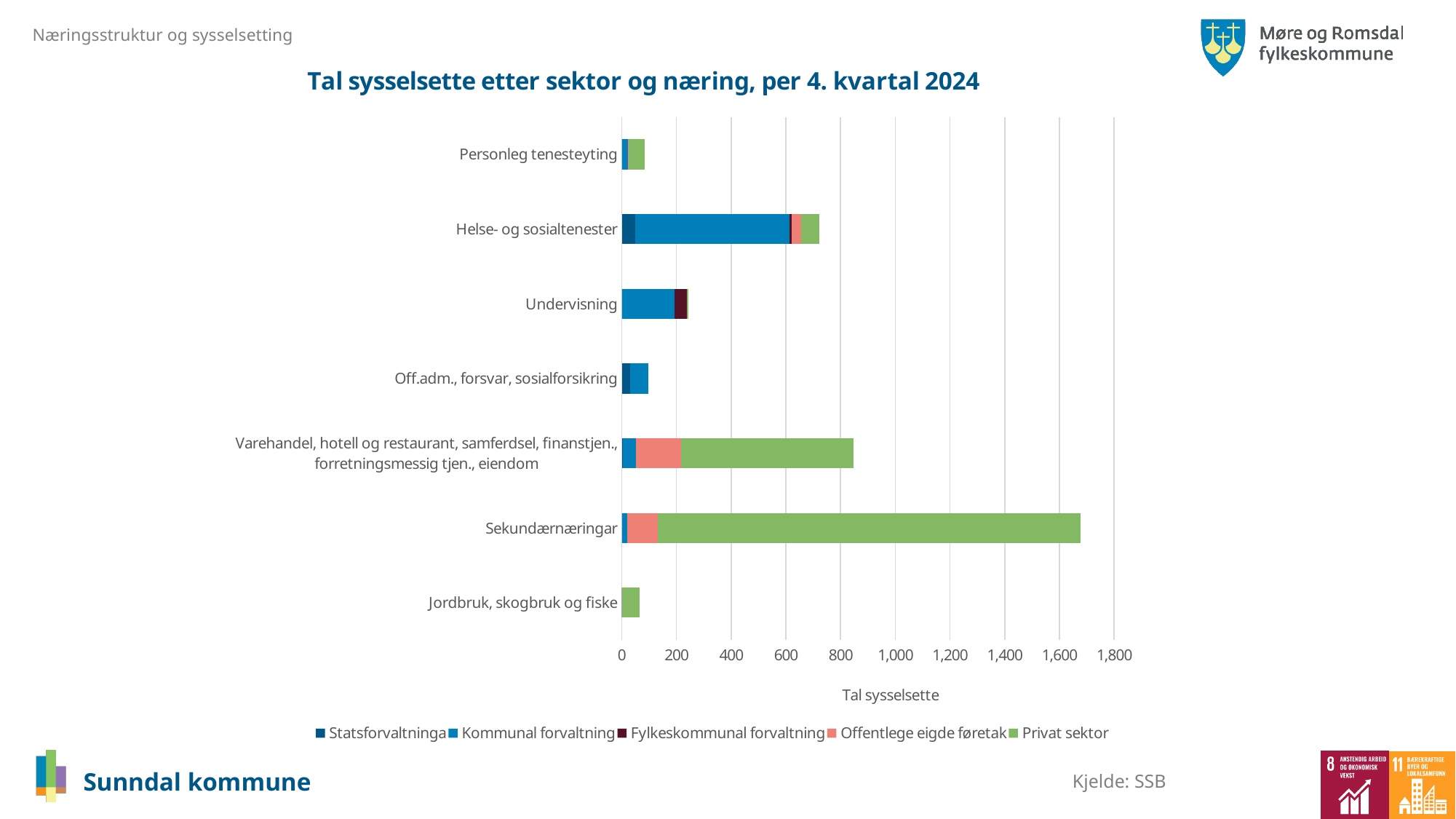
Is the total value for Off.adm., forsvar, sosialforsikring greater or less than 200? less Which category has the highest total number of sysselsette? Sekundærnæringar Which has a larger total, Helse- og sosialtenester or Undervisning? Helse- og sosialtenester Is the total value for Undervisning greater or less than 400? less Is the total value for Helse- og sosialtenester greater or less than 600? greater What kind of chart is shown on the slide? Stacked bar chart What is the title of the chart? Tal sysselsette etter sektor og næring, per 4. kvartal 2024 How many series does the legend list? 5 Which series is shown in green in the legend? Privat sektor How many categories (næringar) are plotted on the y axis? 7